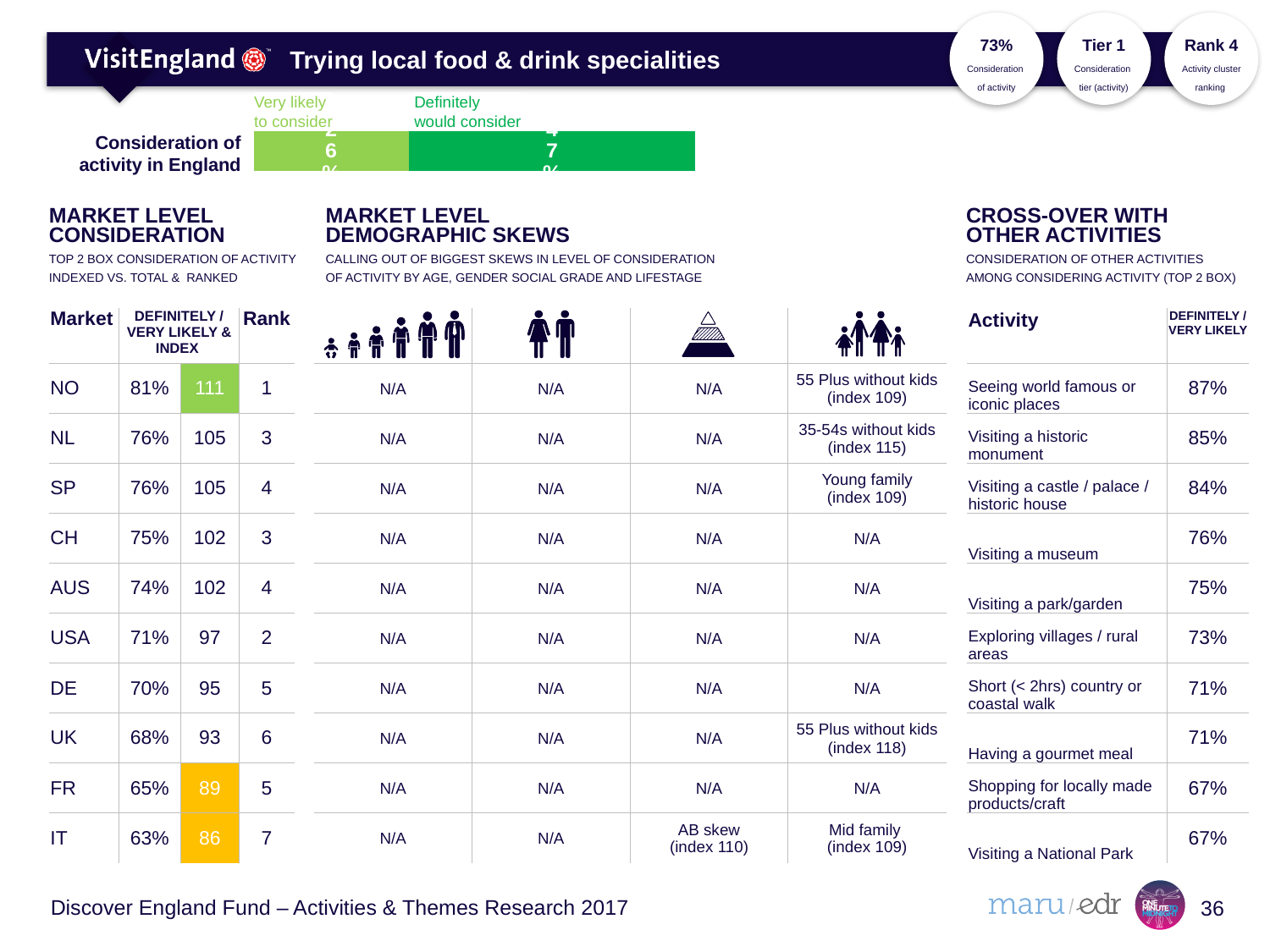
In the 'Consideration of activity in England' chart, which segment is larger: 'Very likely to consider' or 'Definitely would consider'? Definitely would consider How many series does the 'Consideration of activity in England' chart show? 2 How many categories (bars) does the 'Consideration of activity in England' chart have? 1 In the 'Consideration of activity in England' chart, which colour is used for the 'Definitely would consider' segment? dark green What kind of chart is used for 'Consideration of activity in England'? stacked bar chart What are the two series names in the 'Consideration of activity in England' chart? Very likely to consider; Definitely would consider In the 'Consideration of activity in England' chart, which series has the smallest segment? Very likely to consider